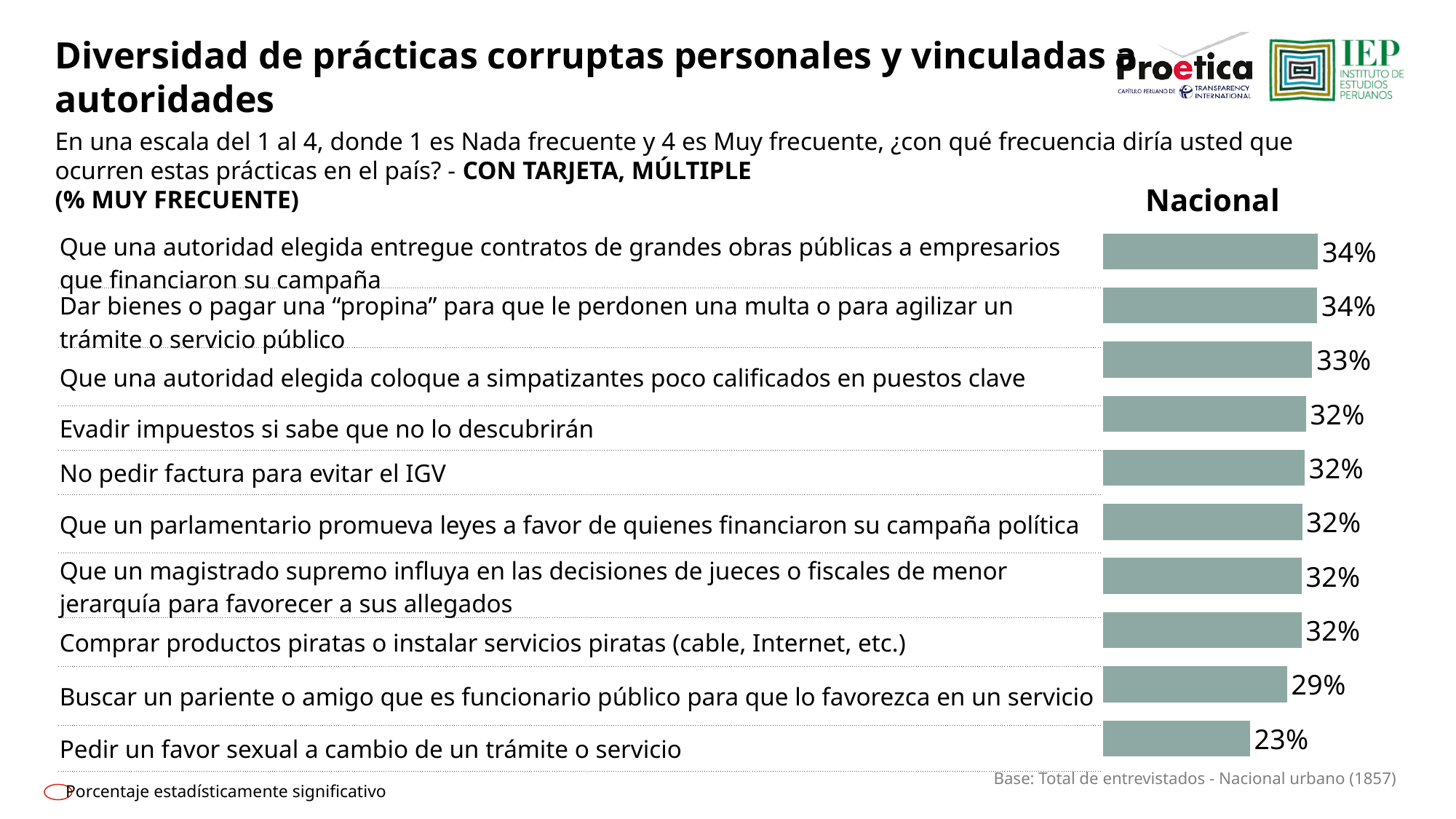
Which is larger: the value for "Comprar productos piratas o instalar servicios piratas (cable, Internet, etc.)" or the value for "Pedir un favor sexual a cambio de un trámite o servicio"? Comprar productos piratas o instalar servicios piratas (cable, Internet, etc.) What is the difference between the value for "Que una autoridad elegida coloque a simpatizantes poco calificados en puestos clave" and the value for "Buscar un pariente o amigo que es funcionario público para que lo favorezca en un servicio"? 4 percentage points What percentage is shown for "Buscar un pariente o amigo que es funcionario público para que lo favorezca en un servicio"? 29% Which practice has the lowest percentage on the chart? Pedir un favor sexual a cambio de un trámite o servicio What percentage is shown for "No pedir factura para evitar el IGV"? 32% What percentage is shown for "Evadir impuestos si sabe que no lo descubrirán"? 32% What is the value for "Que una autoridad elegida coloque a simpatizantes poco calificados en puestos clave"? 33% What kind of chart is shown on the slide? Bar chart What is the value for "Pedir un favor sexual a cambio de un trámite o servicio"? 23% What is the column header shown above the bars? Nacional What is the difference between the value for "Dar bienes o pagar una “propina” para que le perdonen una multa o para agilizar un trámite o servicio público" and the value for "Pedir un favor sexual a cambio de un trámite o servicio"? 11 percentage points How many practices (categories) are plotted on the chart? 10